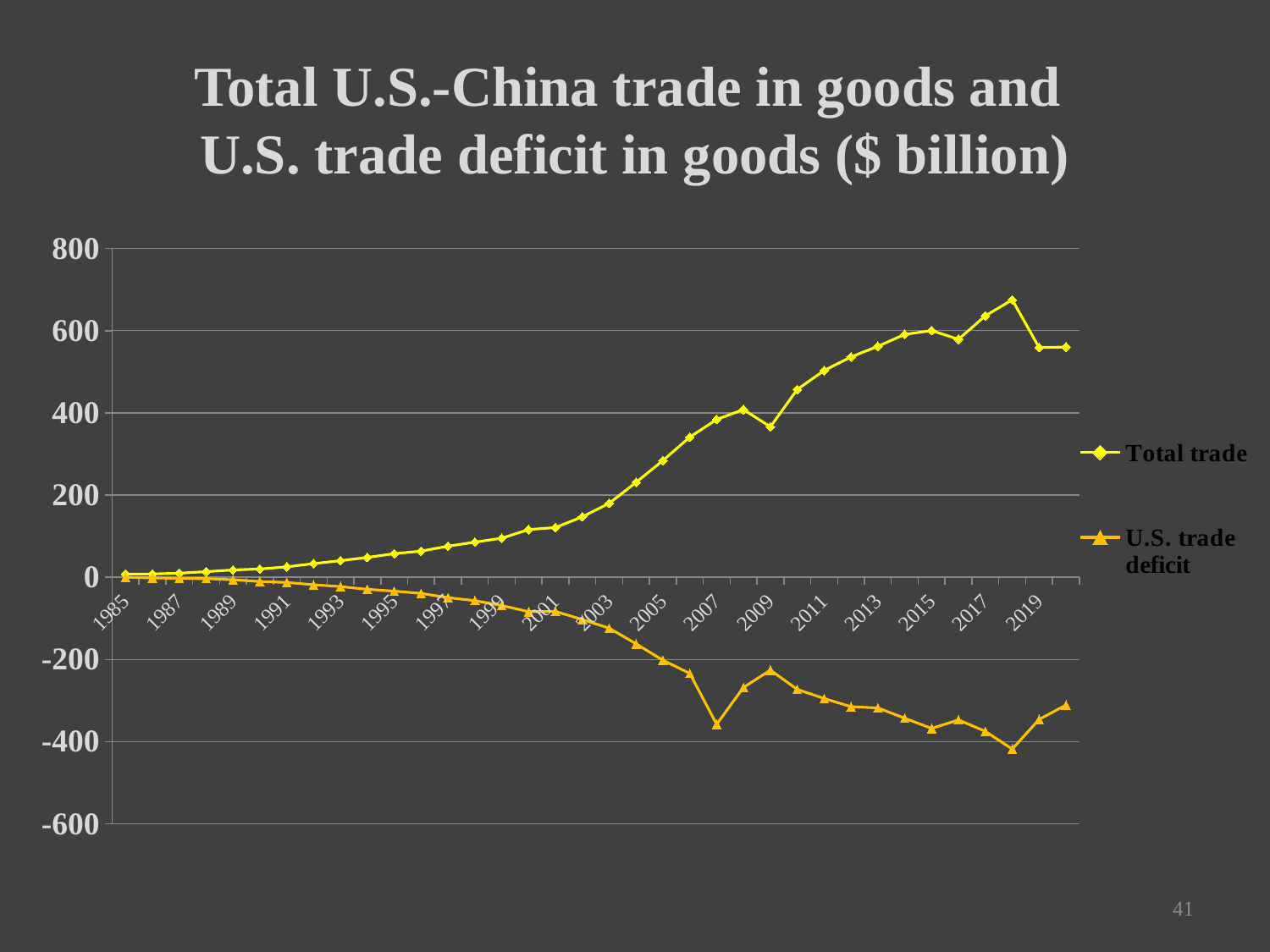
Is the Total trade value for 2019 greater or less than 600? less Is the Total trade value for 2009 greater or less than 400? less What are the two series named in the legend? Total trade and U.S. trade deficit How many series does the legend list? 2 Is the Total trade value for 2017 greater or less than 600? greater In which year does the Total trade series reach its highest value? 2018 What is the title of the chart? Total U.S.-China trade in goods and U.S. trade deficit in goods ($ billion) Does the Total trade series generally rise or fall from 1985 to 2018? Rise What kind of chart is shown on the slide? Line chart